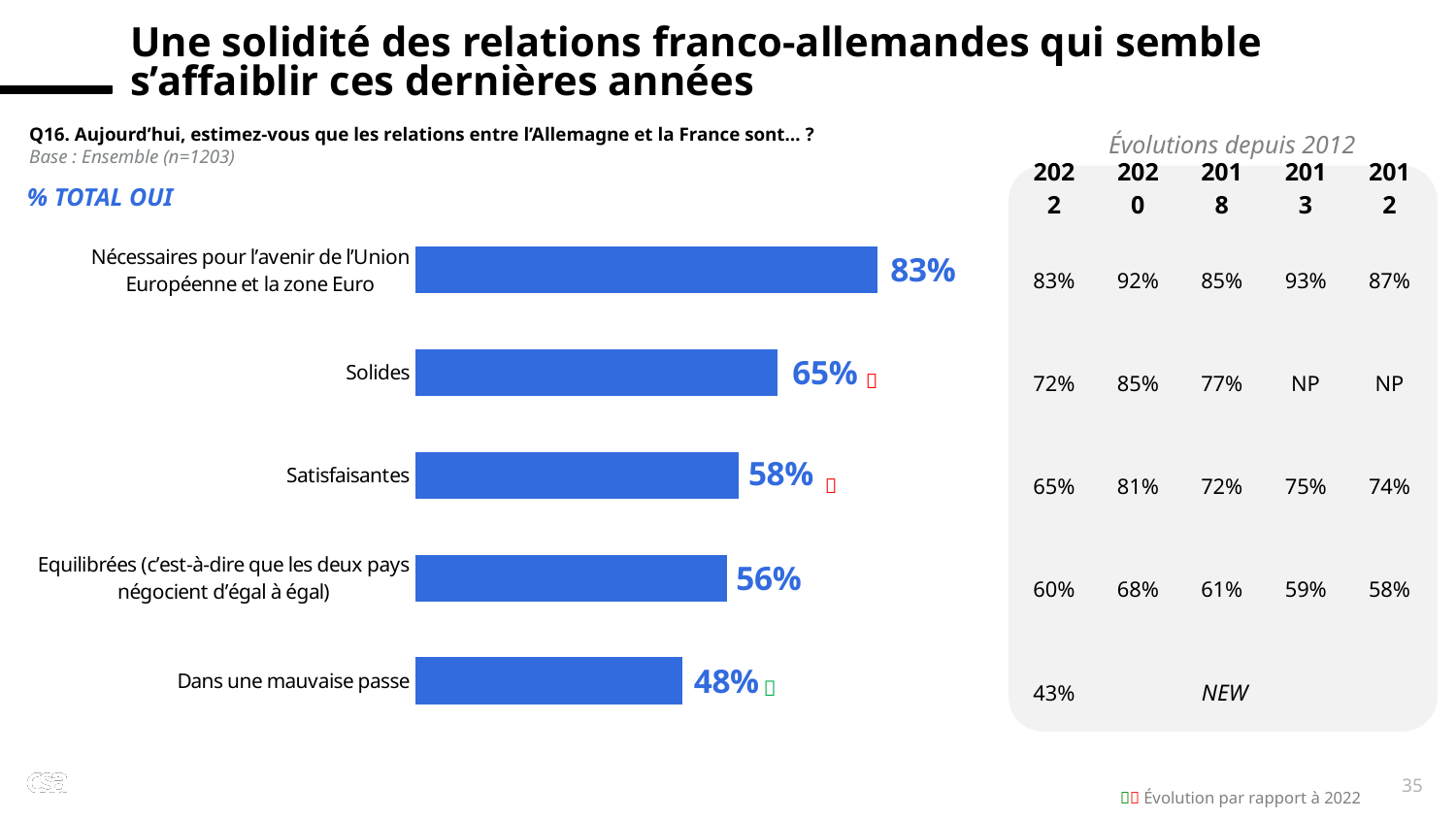
Which category has the highest value? Nécessaires pour l'avenir de l'Union Européenne et la zone Euro What colour are the bars in the chart? Blue What is the value for "Satisfaisantes"? 58% Which is larger, the value for "Satisfaisantes" or the value for "Equilibrées (c'est-à-dire que les deux pays négocient d'égal à égal)"? Satisfaisantes What is the difference between the values for "Satisfaisantes" and "Dans une mauvaise passe"? 10% How many categories does the bar chart show? 5 What is the value for "Solides"? 65% What is the value for "Equilibrées (c'est-à-dire que les deux pays négocient d'égal à égal)"? 56% What is the difference between the values for "Nécessaires pour l'avenir de l'Union Européenne et la zone Euro" and "Solides"? 18% Which category has the lowest value? Dans une mauvaise passe What kind of chart is shown on the slide? Bar chart What is the value for "Dans une mauvaise passe"? 48%